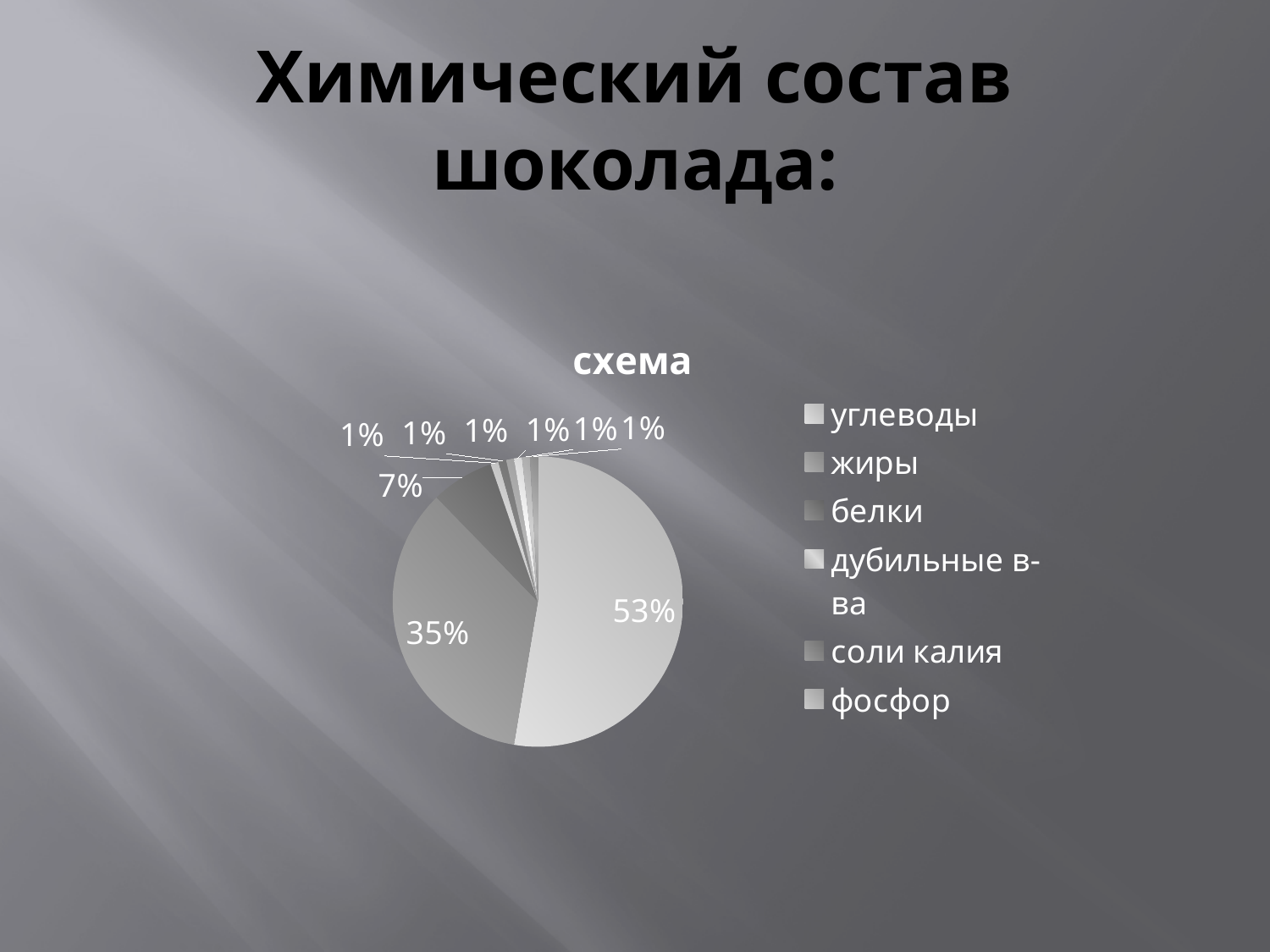
What is the difference in percentage points between жиры and белки? 28 What is the value shown for дубильные в-ва? 1% How many entries does the legend list? 6 What share of the pie does углеводы take? 53% What is the value shown for жиры? 35% What is the title of the chart? схема What is the value shown for белки? 7% Which is larger, the slice for жиры or the slice for белки? жиры How many slices does the pie chart have? 9 What kind of chart is shown on the slide? pie chart What is the difference in percentage points between углеводы and жиры? 18 Which category has the largest slice of the pie? углеводы